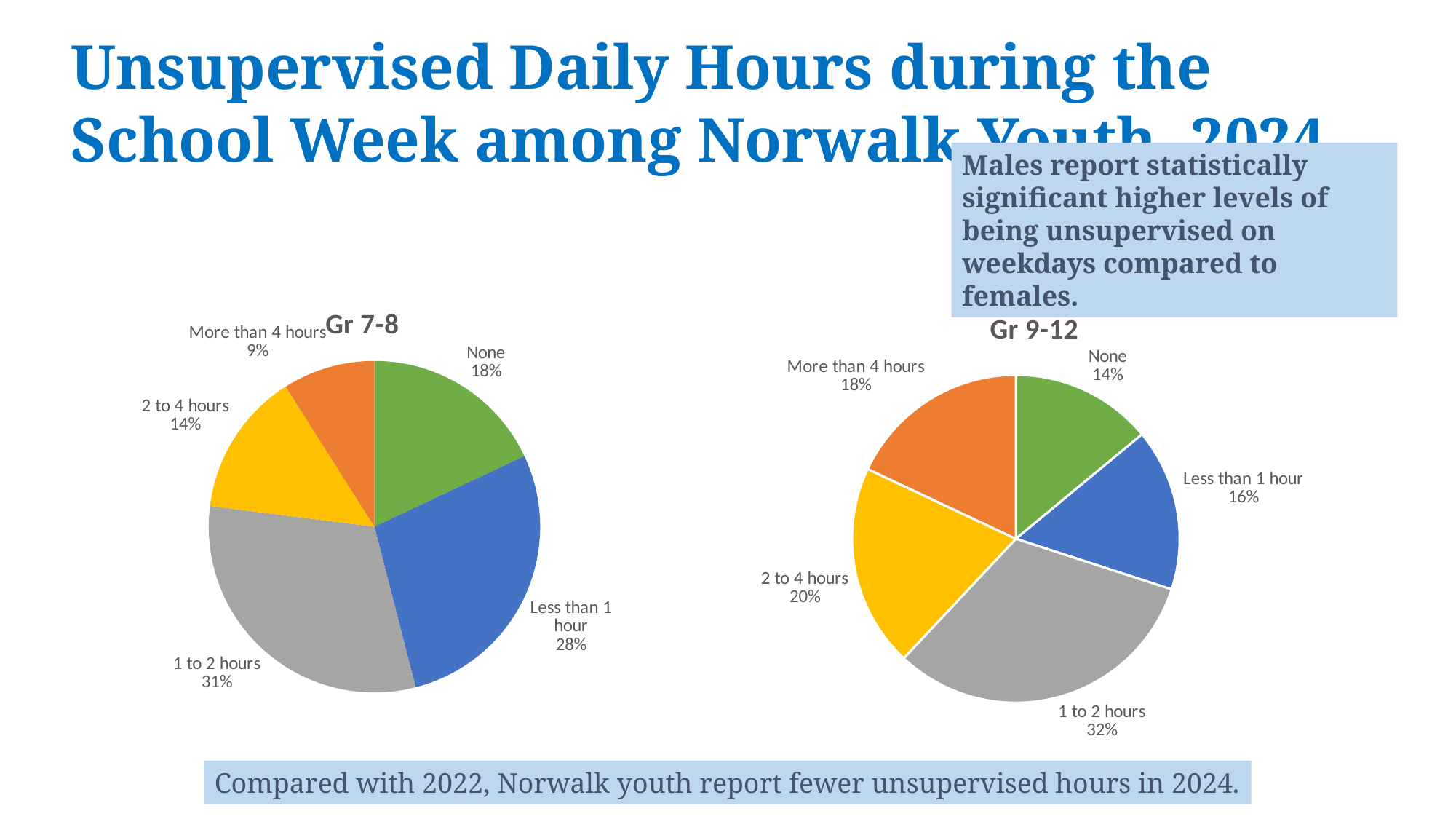
In the Gr 7-8 pie chart, what colour is the slice for 2 to 4 hours? Yellow In the Gr 9-12 pie chart, what is the difference in percentage points between 1 to 2 hours and Less than 1 hour? 16 In the Gr 7-8 pie chart, which category has the smallest share? More than 4 hours In the Gr 9-12 pie chart, what percentage of youth report 2 to 4 hours unsupervised? 20% How many categories are shown in the Gr 9-12 pie chart? 5 In the Gr 9-12 pie chart, what percentage of youth report more than 4 hours unsupervised? 18% In the Gr 7-8 pie chart, which category has the largest share? 1 to 2 hours Which is larger: the share for More than 4 hours in the Gr 7-8 chart or in the Gr 9-12 chart? Gr 9-12 What type of chart is used to show the Gr 7-8 data? Pie chart In the Gr 7-8 pie chart, what percentage of youth report 1 to 2 hours unsupervised? 31% In the Gr 9-12 pie chart, which category has the smallest share? None In the Gr 7-8 pie chart, what percentage of youth report no unsupervised hours (None)? 18%